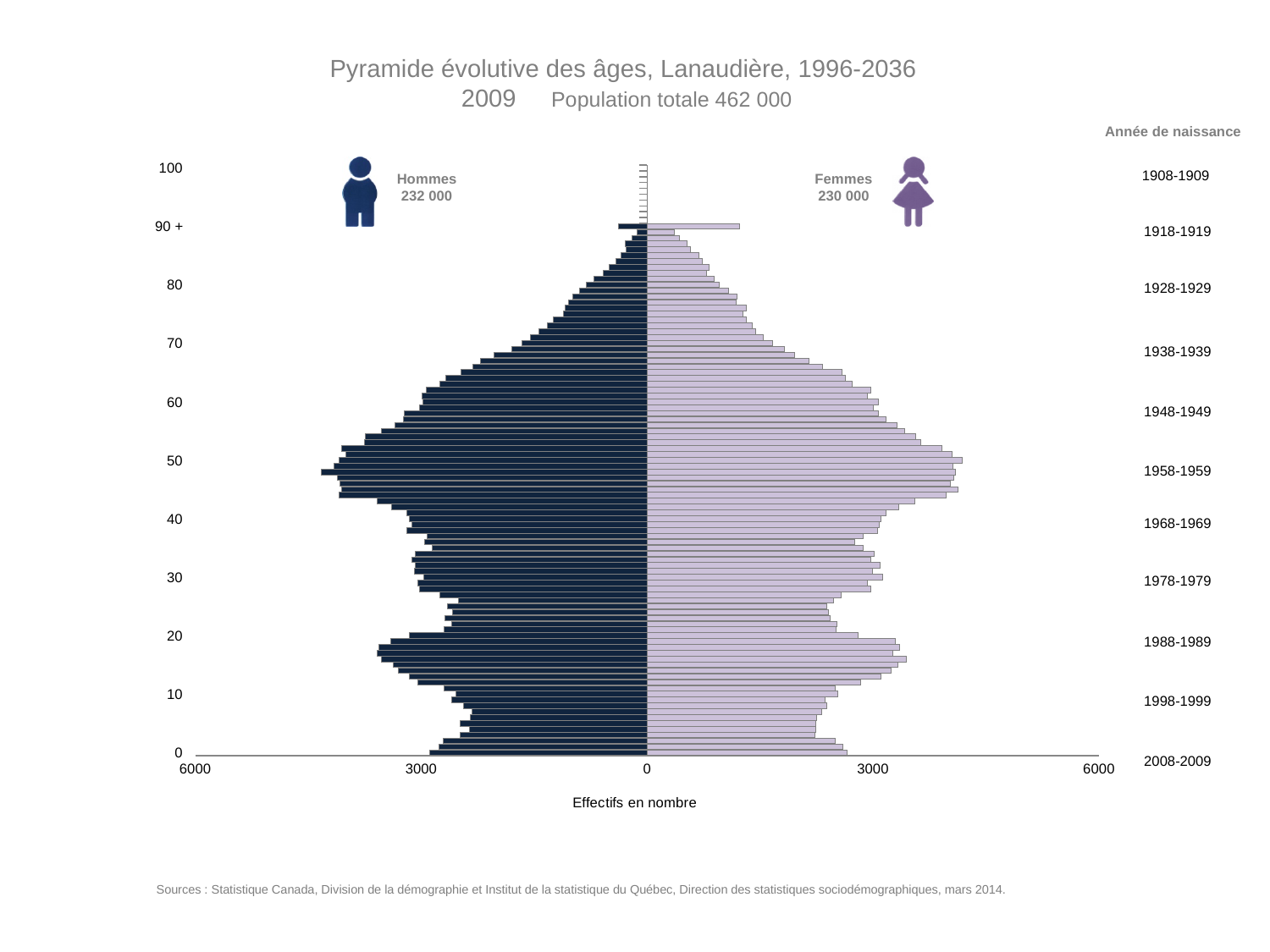
What is the difference between the number of Hommes and the number of Femmes? 2 000 What is the total number of Hommes shown on the chart? 232 000 What kind of chart is shown on the slide? bar chart Is the value for Hommes at around age 48 greater or less than 3000? greater Which group is larger, Hommes or Femmes? Hommes Is the value for Hommes at age 80 greater or less than 3000? less What is the total number of Femmes shown on the chart? 230 000 How many series (population groups) does the chart show? 2 From age 50 up to age 90+, do the bar lengths for Femmes rise or fall? fall What is the Population totale shown on the slide? 462 000 What is the label of the horizontal axis? Effectifs en nombre Which year does the pyramid on the slide represent? 2009